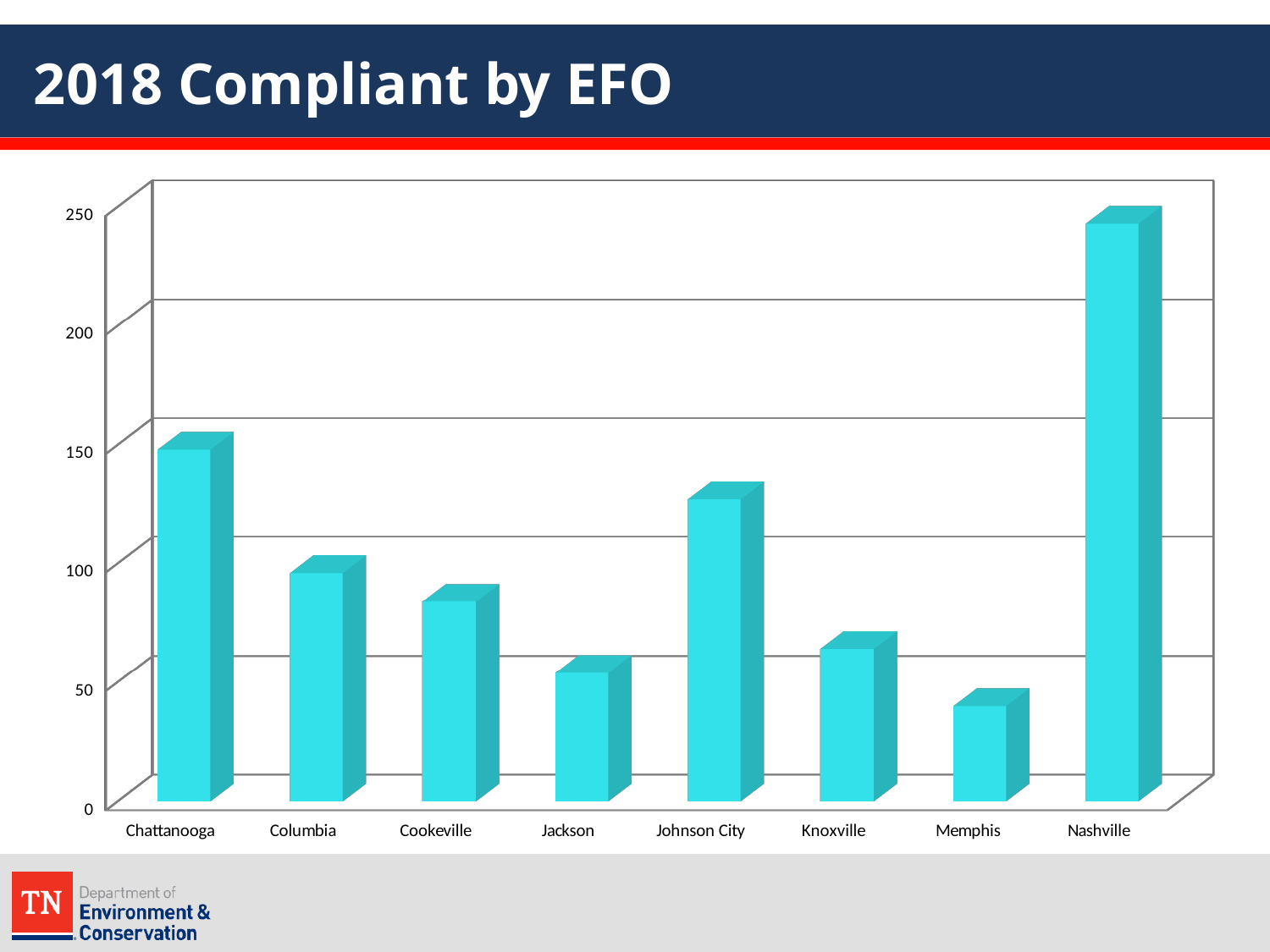
What kind of chart is shown on the slide? bar chart Which is larger, the value for Johnson City or the value for Columbia? Johnson City Is the value for Memphis greater or less than 50? less How many EFO categories are shown on the x axis? 8 What is the title of the chart? 2018 Compliant by EFO Which is larger, the value for Chattanooga or the value for Cookeville? Chattanooga Is the value for Cookeville greater or less than 100? less Is the value for Johnson City greater or less than 150? less Which EFO has the lowest value? Memphis Which EFO has the highest value? Nashville